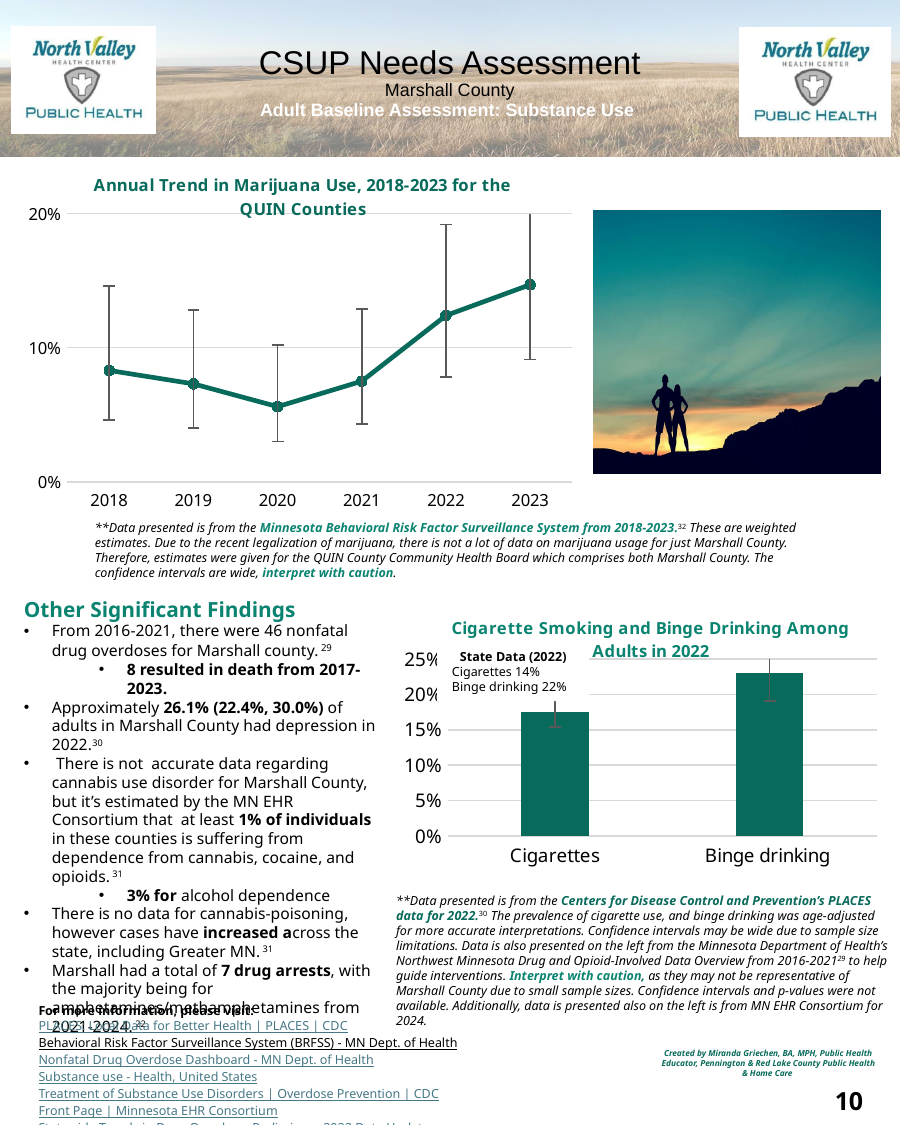
In the 'Annual Trend in Marijuana Use' chart, which year has the larger value, 2019 or 2022? 2022 In the 'Annual Trend in Marijuana Use' chart, is the value for 2023 greater or less than 10%? greater What kind of chart is the 'Cigarette Smoking and Binge Drinking Among Adults in 2022' chart? bar chart In the 'Cigarette Smoking and Binge Drinking Among Adults in 2022' chart, is the value for Cigarettes greater or less than 15%? greater In the 'Annual Trend in Marijuana Use' chart, how many years are plotted along the x axis? 6 In the 'Cigarette Smoking and Binge Drinking Among Adults in 2022' chart, how many categories are shown? 2 In the 'Annual Trend in Marijuana Use' chart, do the values rise or fall from 2020 to 2023? rise In the 'Annual Trend in Marijuana Use' chart, which year has the lowest value? 2020 In the 'Cigarette Smoking and Binge Drinking Among Adults in 2022' chart, which category has the higher value? Binge drinking In the 'Annual Trend in Marijuana Use' chart, which year has the highest value? 2023 What kind of chart is the 'Annual Trend in Marijuana Use, 2018-2023 for the QUIN Counties' chart? line chart In the 'Annual Trend in Marijuana Use' chart, is the value for 2020 greater or less than 10%? less